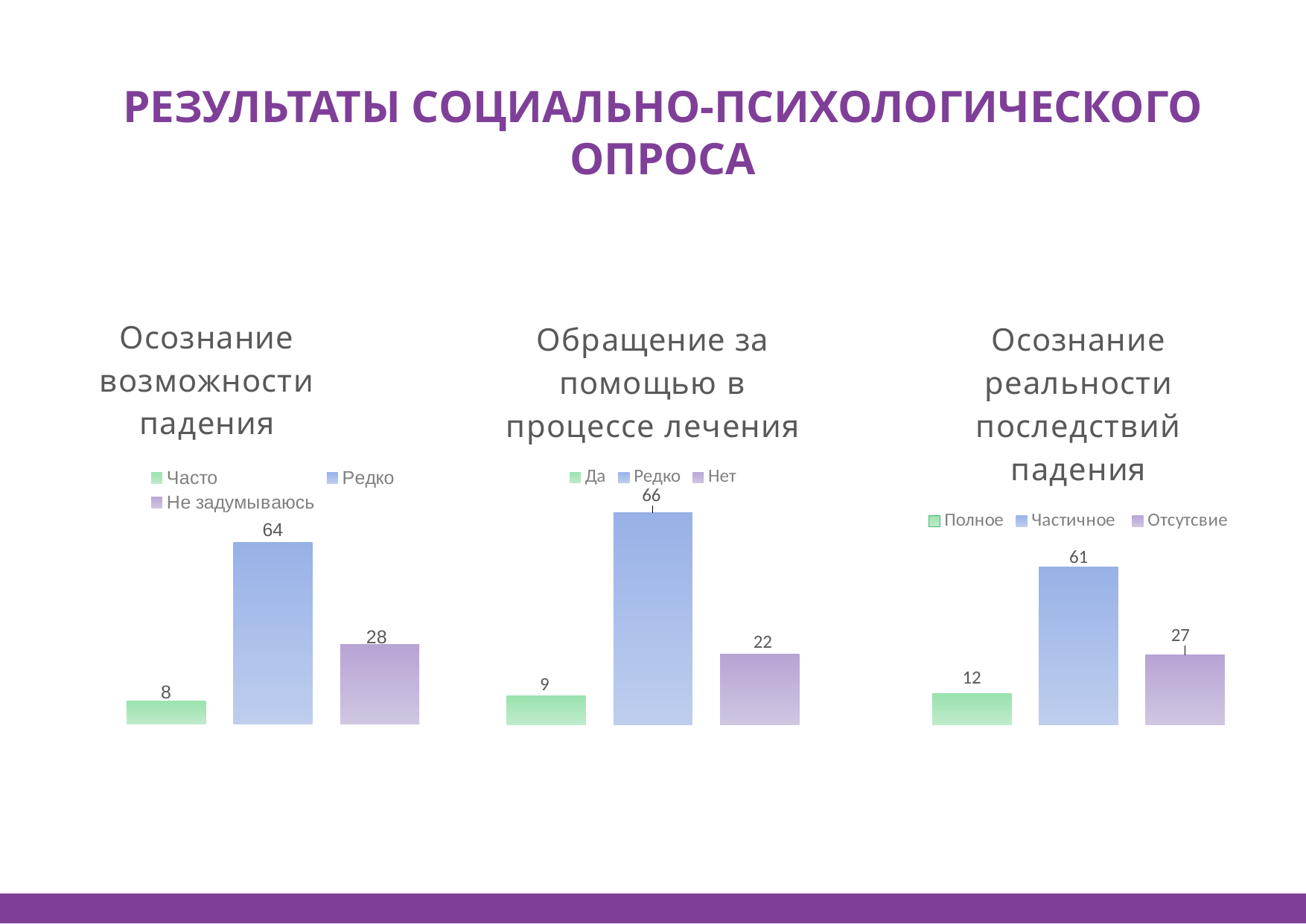
In the chart titled "Осознание реальности последствий падения", what is the value for "Полное"? 12 In the chart titled "Осознание возможности падения", what is the value for "Редко"? 64 In the chart titled "Осознание возможности падения", what is the value for "Часто"? 8 In the chart titled "Обращение за помощью в процессе лечения", which category has the lowest value? Да In the chart titled "Осознание возможности падения", what is the difference between the values for "Редко" and "Не задумываюсь"? 36 In the chart titled "Осознание реальности последствий падения", what is the difference between the values for "Отсутсвие" and "Полное"? 15 In the chart titled "Осознание реальности последствий падения", which category has the highest value? Частичное How many series does the legend list in the chart titled "Осознание реальности последствий падения"? 3 In the chart titled "Обращение за помощью в процессе лечения", which is larger: the value for "Редко" or the value for "Нет"? Редко How many charts are shown on the slide? 3 In the chart titled "Обращение за помощью в процессе лечения", what is the value for "Нет"? 22 What kind of chart is the chart titled "Обращение за помощью в процессе лечения"? Bar chart